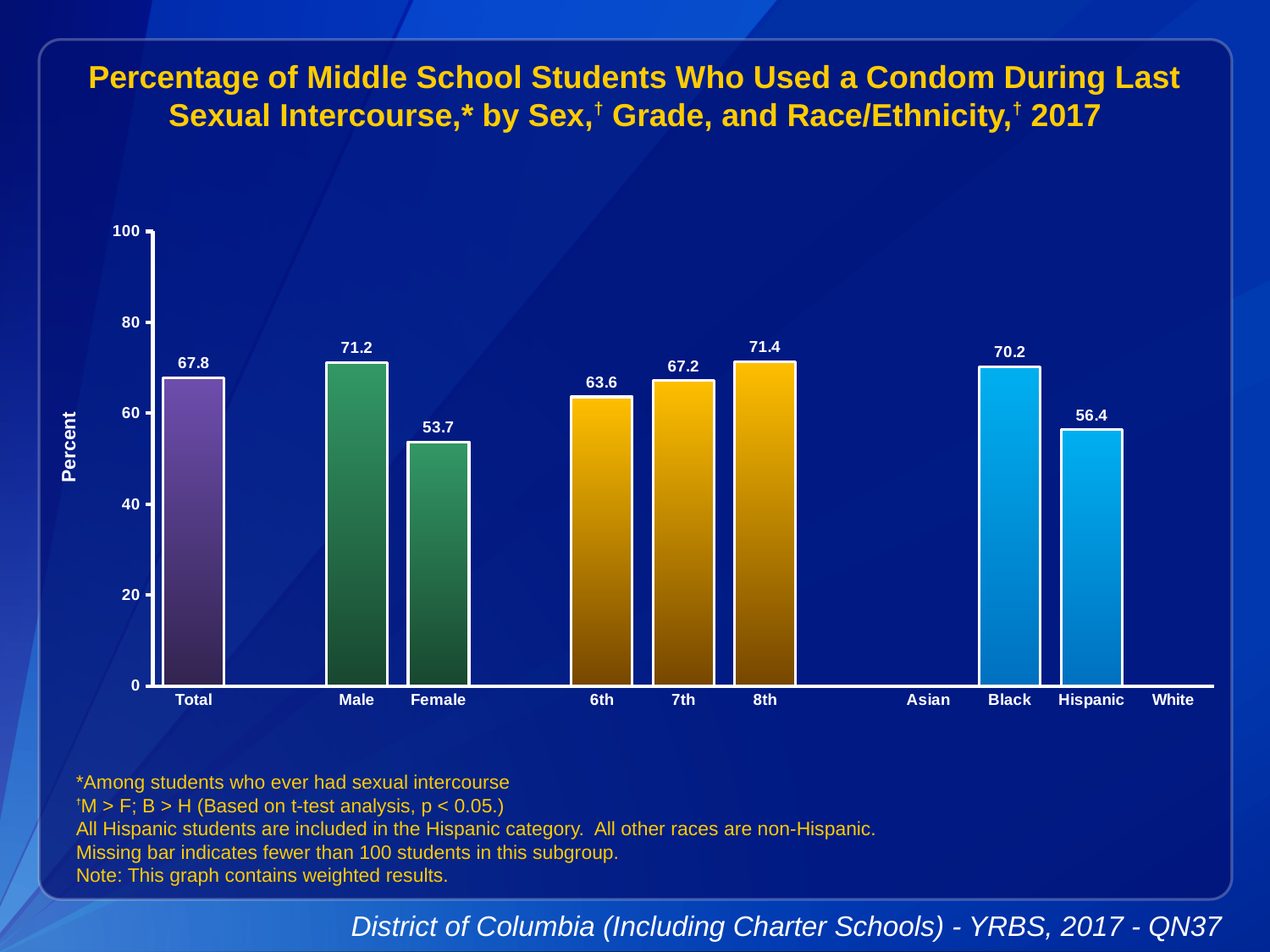
Which is larger, the value for Black or the value for Hispanic? Black What kind of chart is shown? Bar chart Is the value for 6th grade greater or less than 60? greater What is the value for 8th grade? 71.4 What is the value for Female? 53.7 How many categories are labeled on the x axis? 10 Which category has the highest value? 8th What is the value for Total? 67.8 What is the value for Hispanic? 56.4 Which category has the lowest value among the bars shown? Female What is the difference between the Male and Female values? 17.5 Do the values rise or fall from 6th grade to 8th grade? Rise